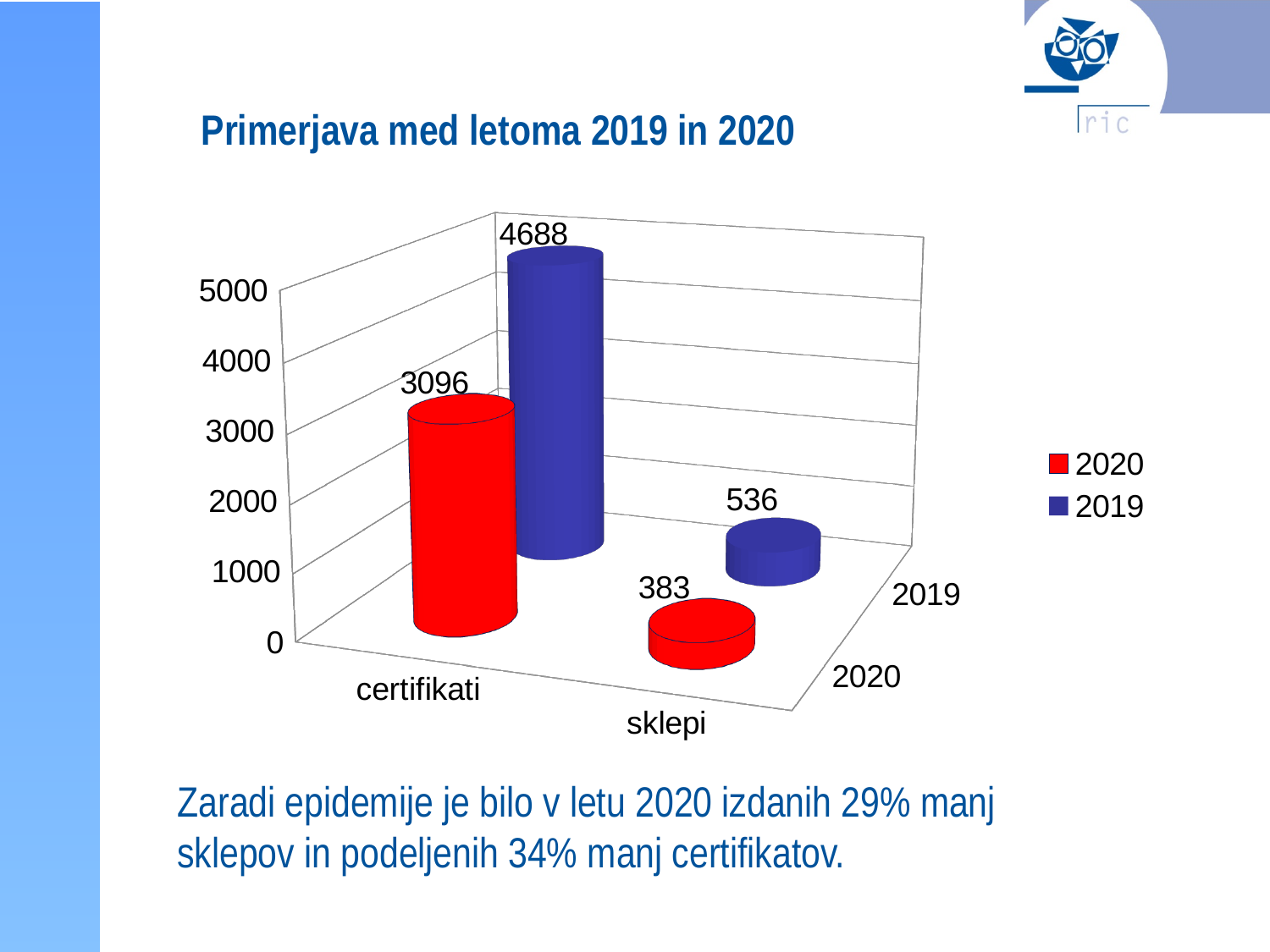
What is the value for certifikati in 2019? 4688 What kind of chart is shown on the slide? bar chart What is the value for certifikati in 2020? 3096 How many series does the legend list? 2 What is the difference between the certifikati values for 2019 and 2020? 1592 What is the difference between the sklepi values for 2019 and 2020? 153 Which bar has the highest value in the chart? certifikati in 2019 Which is larger, the certifikati value for 2020 or the sklepi value for 2019? certifikati for 2020 What is the value for sklepi in 2019? 536 Which bar has the lowest value in the chart? sklepi in 2020 What is the value for sklepi in 2020? 383 How many categories are shown on the x axis of the chart? 2